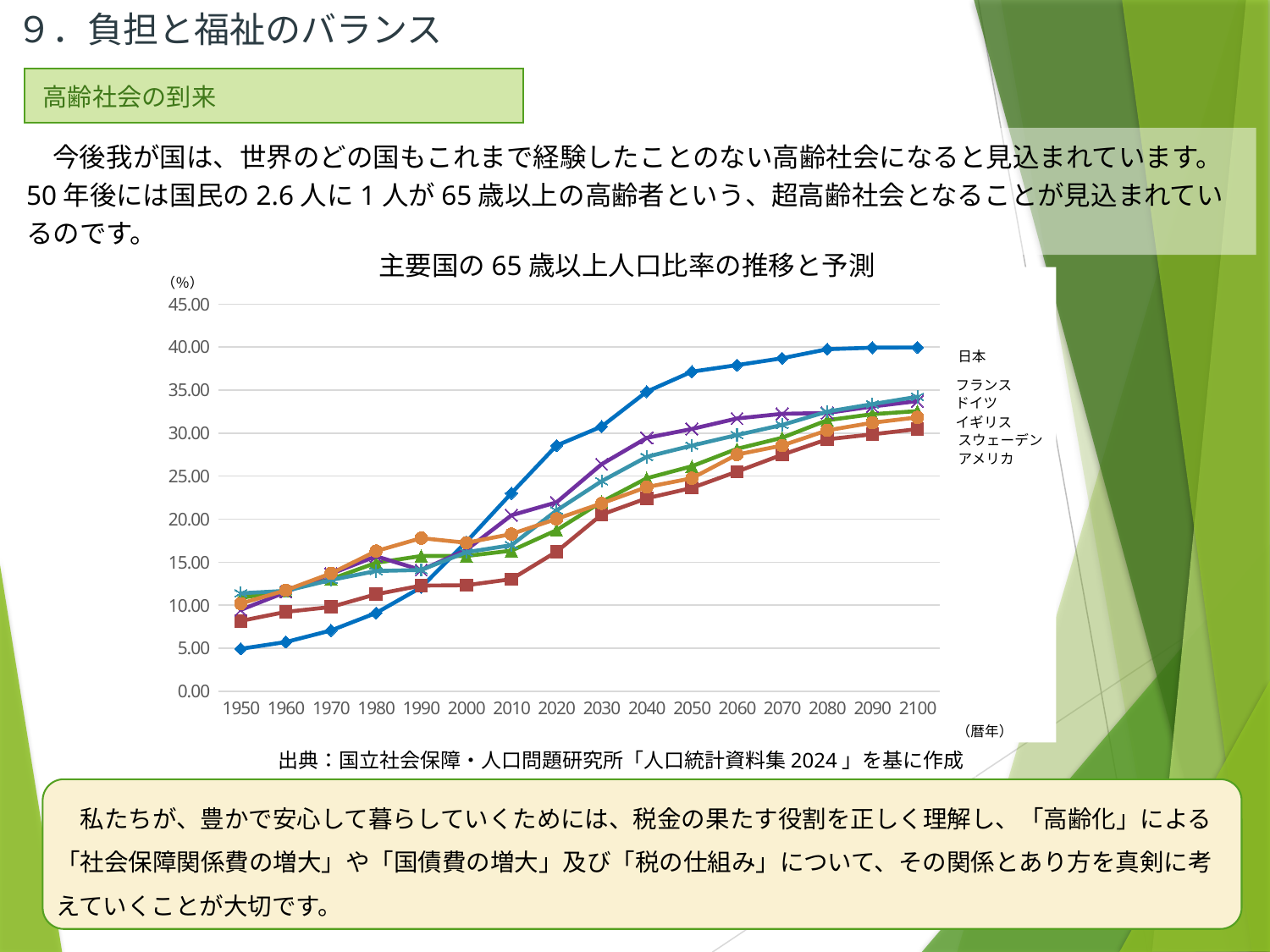
Which country has the lowest value in 2100? アメリカ How many years are plotted along the x axis of the chart? 16 Is the value for 日本 in 2050 greater or less than 35? greater Which country has the lowest value in 1950? 日本 How many series (countries) does the chart show? 6 What kind of chart is shown on the slide? line chart Does the value for 日本 rise or fall from 1950 to 2100? rise Which country has the highest value in 2100? 日本 Is the value for 日本 in 2020 greater or less than 25? greater What is the title of the chart? 主要国の65歳以上人口比率の推移と予測 In 2050, which is larger, the value for 日本 or the value for アメリカ? 日本 Is the value for 日本 in 1950 greater or less than 10? less